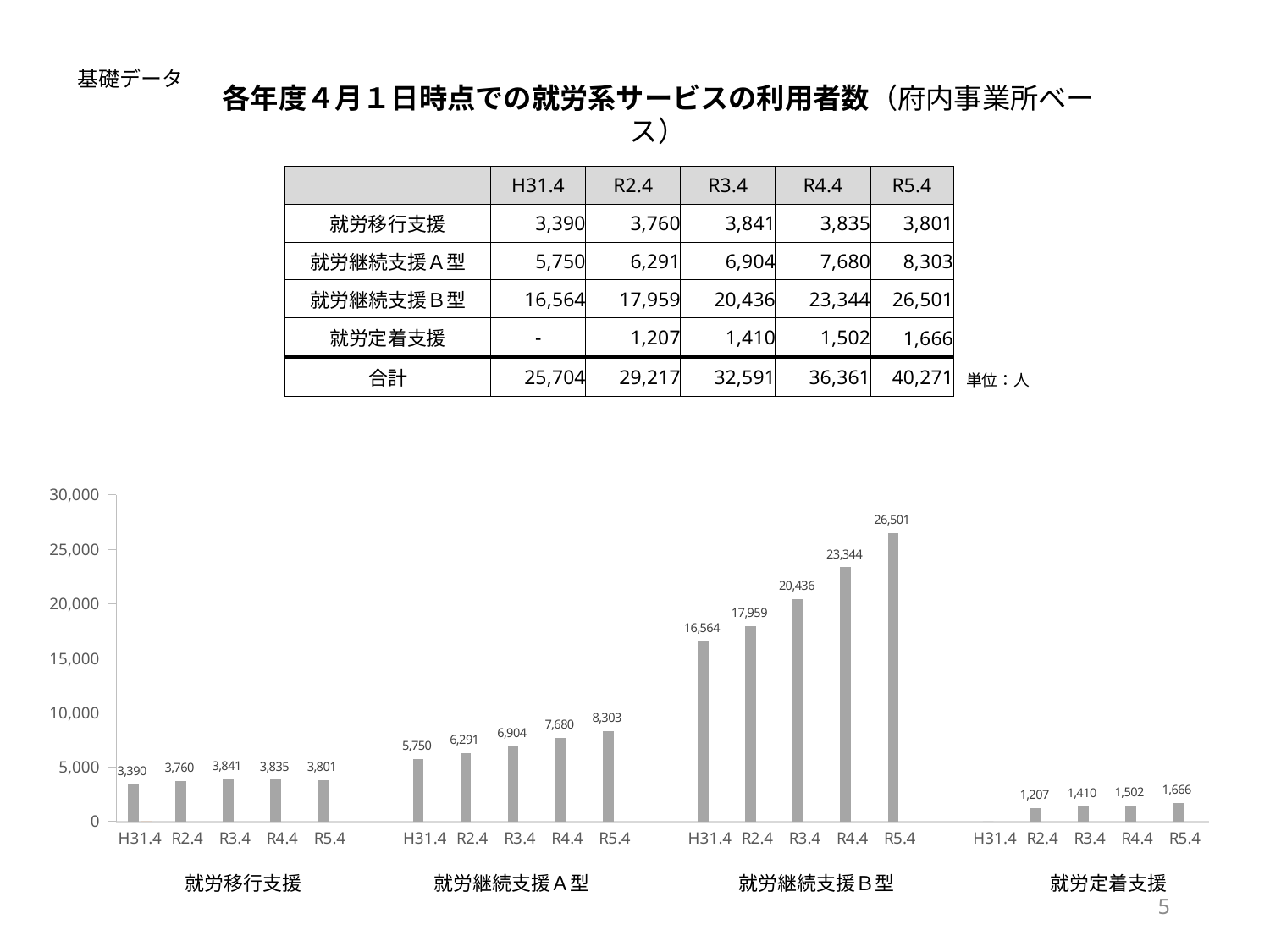
Which bar in the 就労継続支援Ａ型 group is the lowest? H31.4 What is the value for 就労移行支援 at H31.4? 3,390 What is the value for 就労継続支援Ｂ型 at R5.4? 26,501 What is the difference between the R5.4 and R2.4 values for 就労定着支援? 459 What is the value for 就労継続支援Ａ型 at R4.4? 7,680 Which is larger: the R5.4 value for 就労継続支援Ａ型 or the R5.4 value for 就労移行支援? 就労継続支援Ａ型 What kind of chart is shown on the slide? bar chart What is the difference between the R5.4 and H31.4 values for 就労継続支援Ｂ型? 9,937 What is the value for 就労定着支援 at R3.4? 1,410 Which bar in the 就労継続支援Ｂ型 group is the highest? R5.4 Is the R5.4 value for 就労継続支援Ｂ型 greater or less than 25,000? greater Do the values for 就労継続支援Ｂ型 rise or fall from H31.4 to R5.4? rise